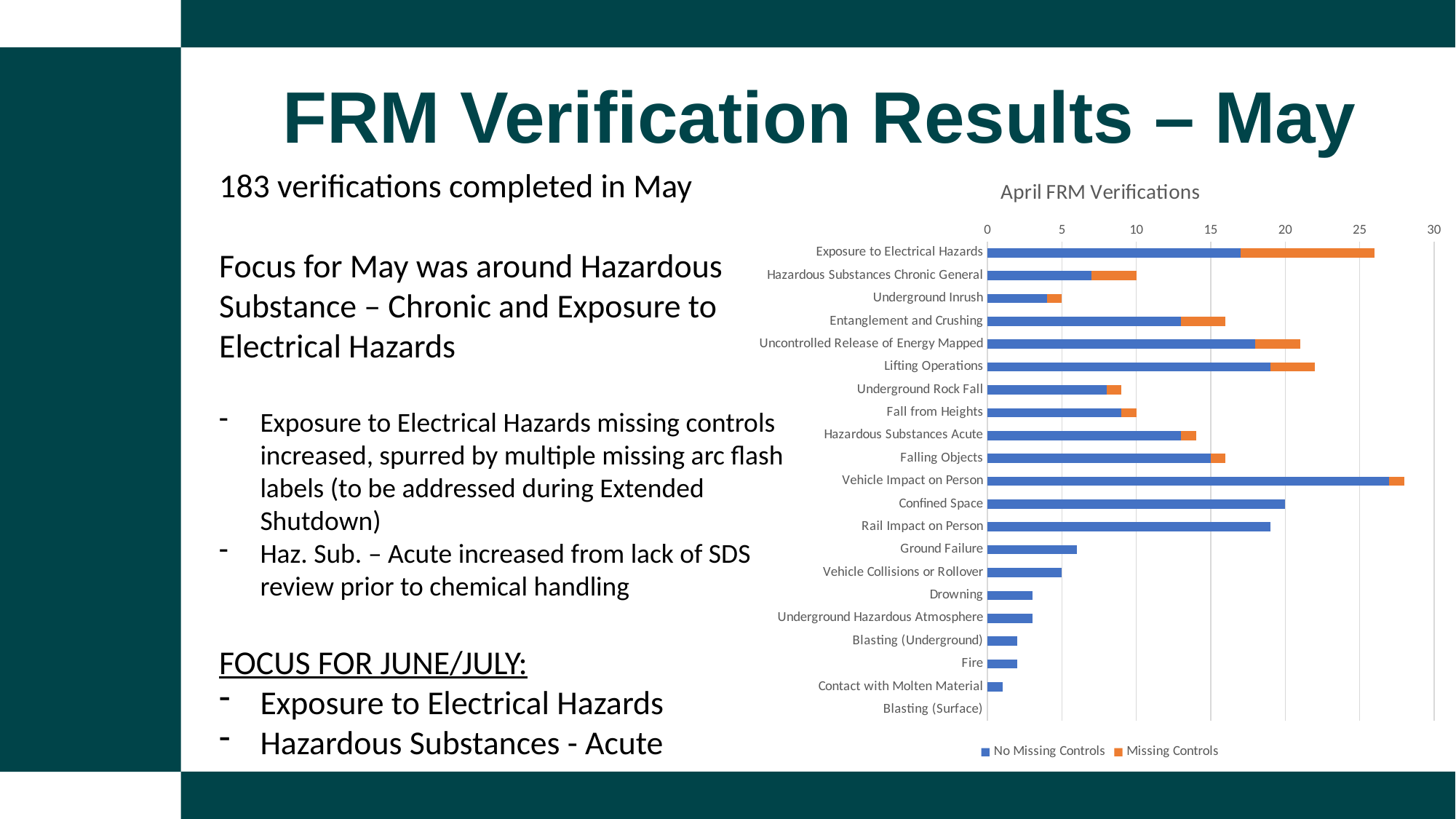
Which category has the longest Missing Controls (orange) segment? Exposure to Electrical Hazards Which category has the lowest total on the chart? Blasting (Surface) How many categories are plotted on the chart? 21 Is the total bar length for Confined Space greater or less than 15? greater What are the two series named in the chart's legend? No Missing Controls and Missing Controls Is the total bar length for Drowning greater or less than 5? less Is the total bar length for Exposure to Electrical Hazards greater or less than 20? greater How many series does the chart's legend list? 2 What kind of chart is shown on the slide? bar chart What is the title of the chart? April FRM Verifications Which has the longer total bar, Lifting Operations or Underground Inrush? Lifting Operations